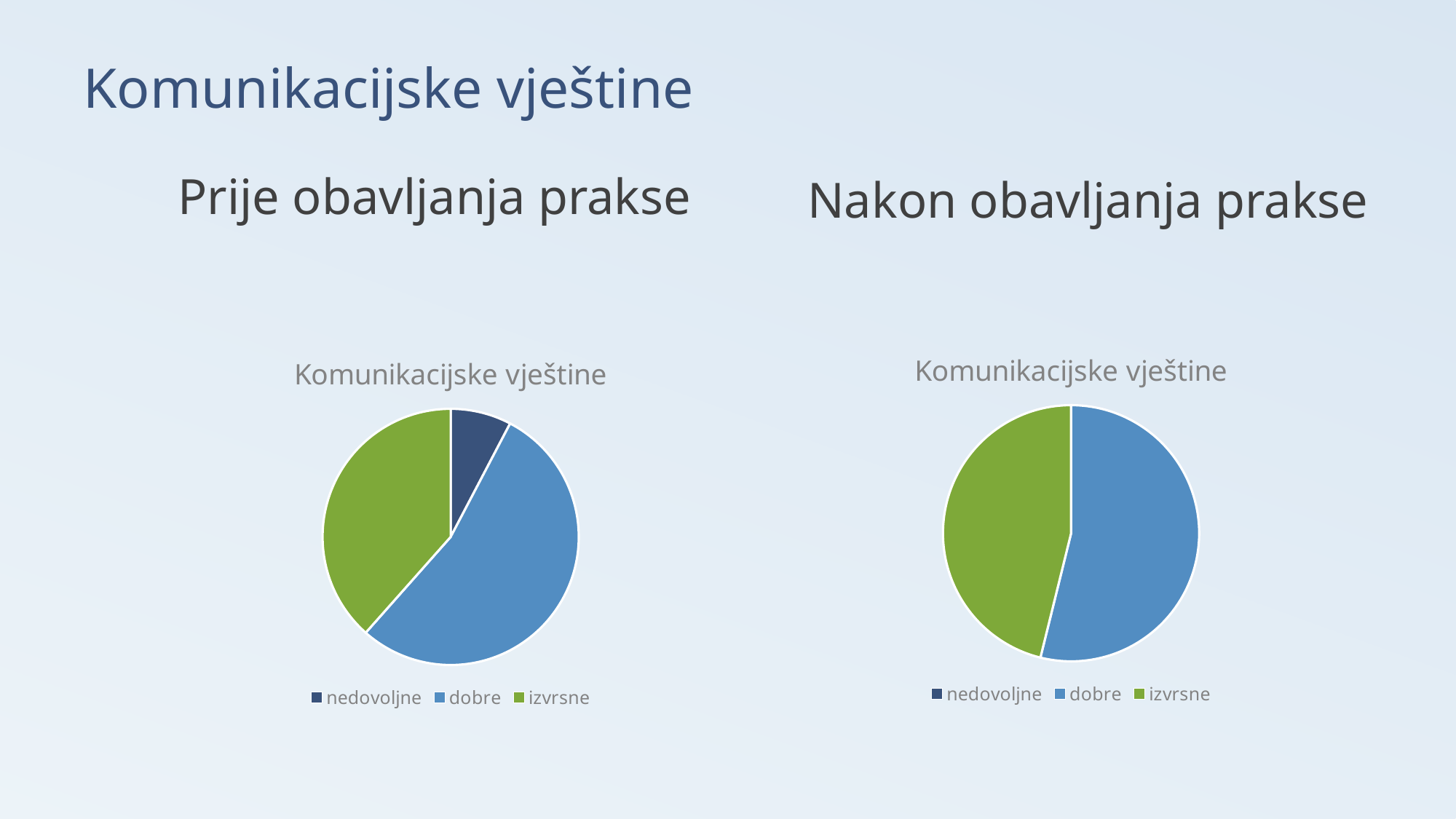
In the "Prije obavljanja prakse" chart, which category has the largest slice? dobre In the "Prije obavljanja prakse" chart, which slice is larger, nedovoljne or izvrsne? izvrsne In the "Prije obavljanja prakse" chart, how many categories does the legend list? 3 In the "Prije obavljanja prakse" chart, how many slices are visible in the pie? 3 What is the title of the chart under "Nakon obavljanja prakse"? Komunikacijske vještine In the "Nakon obavljanja prakse" chart, how many slices are visible in the pie? 2 In the "Prije obavljanja prakse" chart, which slice is larger, nedovoljne or dobre? dobre In the "Nakon obavljanja prakse" chart, how many categories does the legend list? 3 What kind of chart is shown under "Nakon obavljanja prakse"? pie chart What kind of chart is shown under "Prije obavljanja prakse"? pie chart In the "Prije obavljanja prakse" chart, which category has the smallest slice? nedovoljne In the "Prije obavljanja prakse" chart, what colour represents izvrsne? green